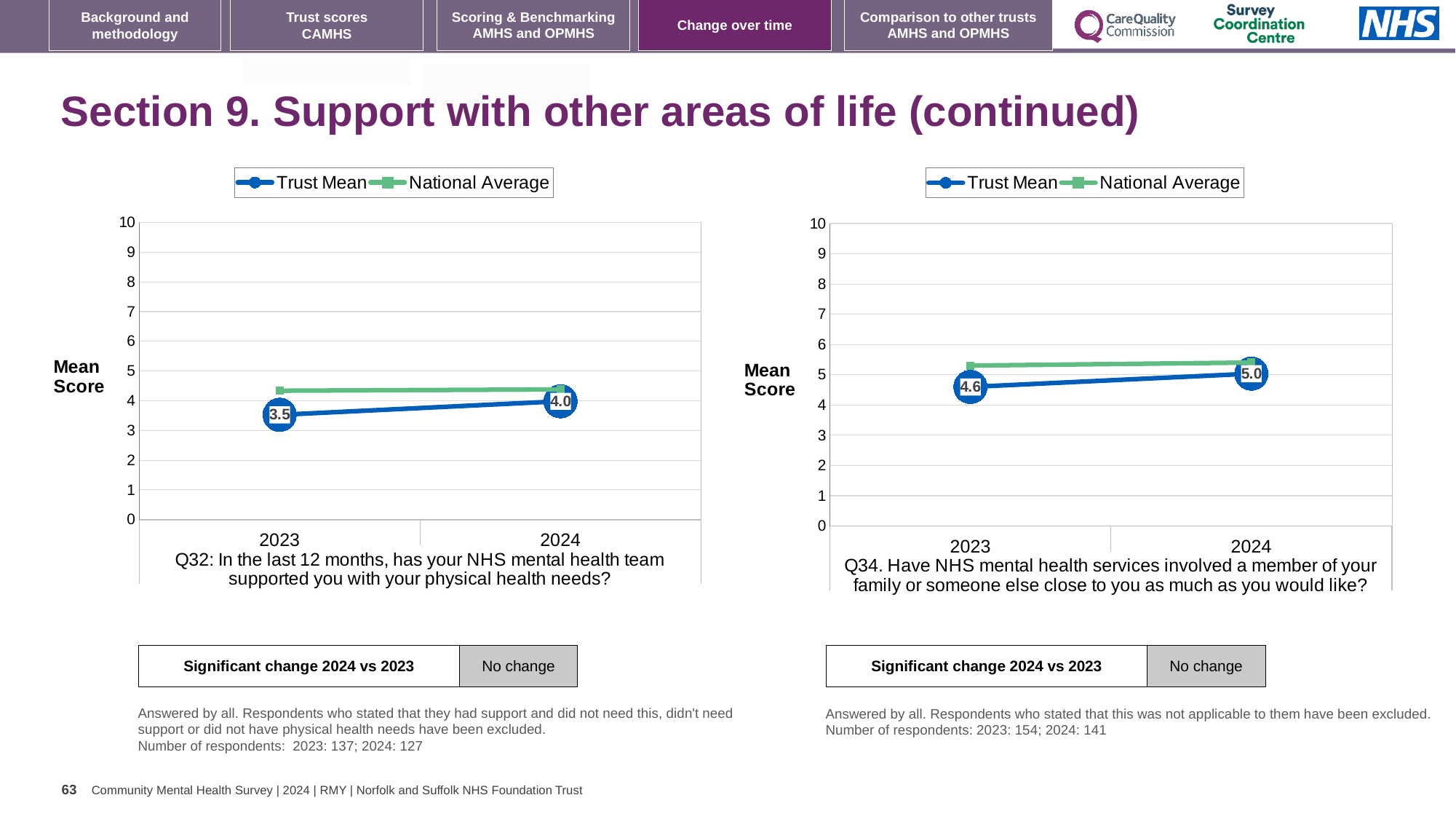
What kind of chart is the left chart (Q32)? line chart In the left chart (Q32), what is the Trust Mean value for 2024? 4.0 In the right chart (Q34), what is the Trust Mean value for 2023? 4.6 In the right chart (Q34), does the Trust Mean rise or fall from 2023 to 2024? rise In the left chart (Q32), what is the Trust Mean value for 2023? 3.5 In the right chart (Q34), which series has the higher value in 2023, Trust Mean or National Average? National Average In the right chart (Q34), by how much did the Trust Mean change from 2023 to 2024? 0.4 How many series does the legend of the right chart (Q34) list? 2 In the right chart (Q34), what is the Trust Mean value for 2024? 5.0 How many years are shown on the x axis of the left chart (Q32)? 2 In the left chart (Q32), by how much did the Trust Mean change from 2023 to 2024? 0.5 In the left chart (Q32), is the National Average value for 2023 greater or less than 4? greater